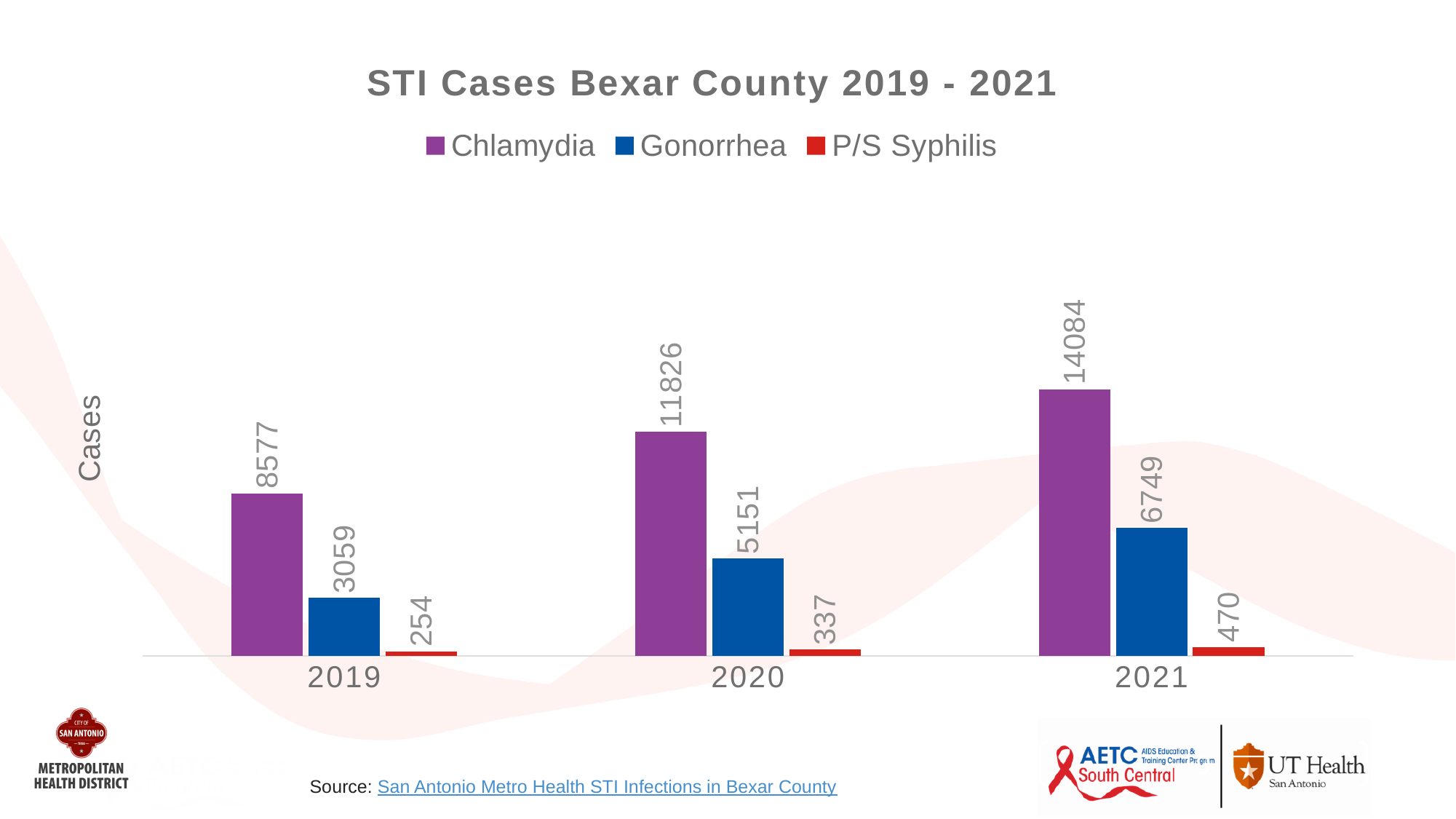
What is the number of P/S Syphilis cases in 2020? 337 How many series does the legend list? 3 What is the difference between Gonorrhea cases in 2020 and 2019? 2092 Which had more cases in 2020, Gonorrhea or P/S Syphilis? Gonorrhea How many years are shown on the x axis? 3 In which year were P/S Syphilis cases lowest? 2019 What is the number of Gonorrhea cases in 2021? 6749 Do Gonorrhea cases rise or fall from 2019 to 2021? Rise What is the number of Chlamydia cases in 2019? 8577 What is the difference between Chlamydia cases in 2021 and 2020? 2258 In which year were Chlamydia cases highest? 2021 What kind of chart is shown on the slide? Bar chart